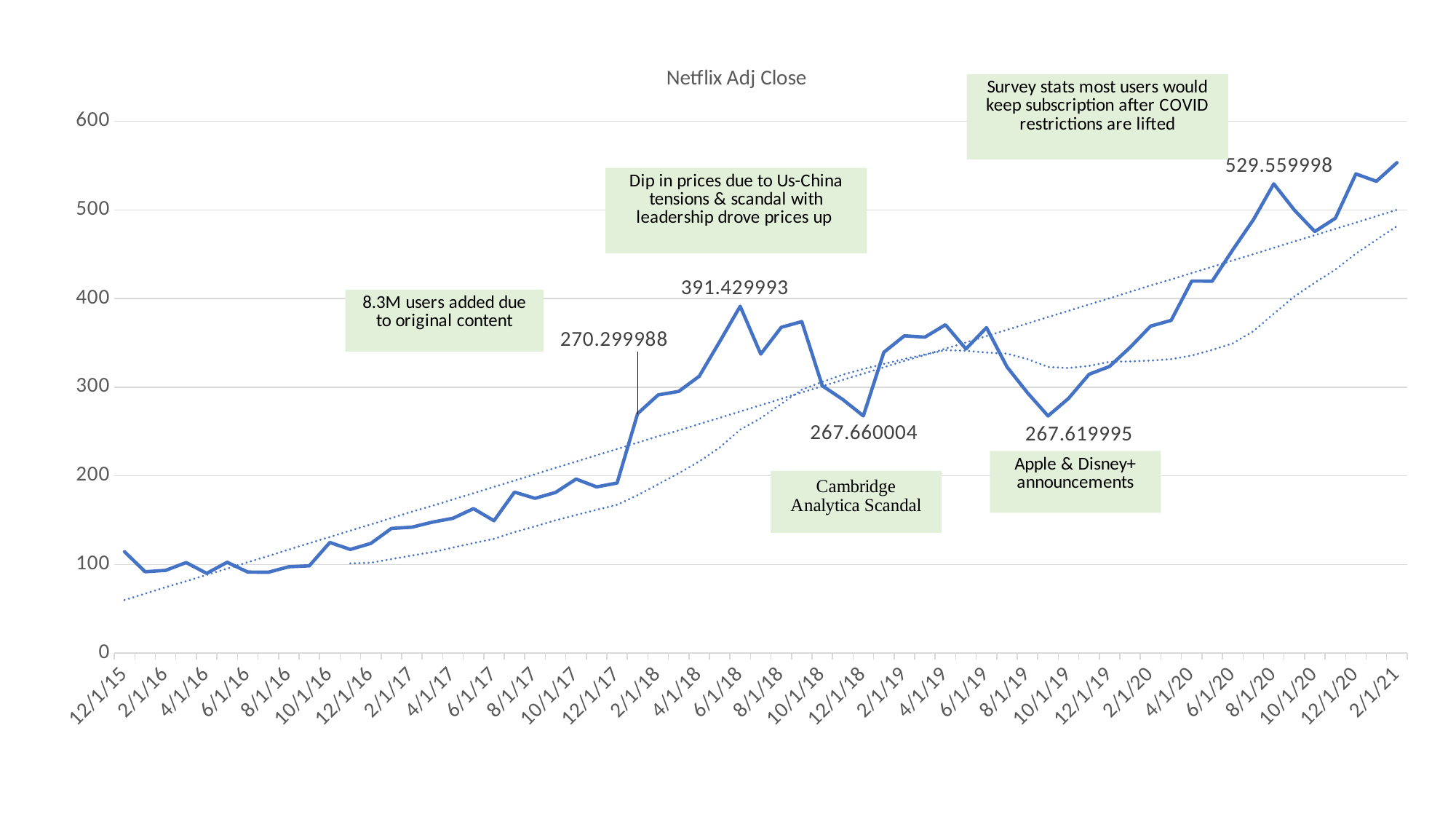
What value is labeled at the dip near 12/1/18? 267.660004 Is the value for 2/1/21 greater or less than 500? greater What is the highest data label printed on the chart? 529.559998 What value is labeled at the peak of the line in mid-2018? 391.429993 What is the title of the chart? Netflix Adj Close How many data points on the line have printed value labels? 5 Overall, does the Netflix Adj Close line rise or fall from 12/1/15 to 2/1/21? rise What is the lowest data label printed on the chart? 267.619995 What kind of chart is shown on the slide? line chart Is the value for 12/1/15 greater or less than 100? greater Which labeled value is larger: 267.660004 or 267.619995? 267.660004 What is the difference between the labeled values 391.429993 and 267.660004? 123.769989